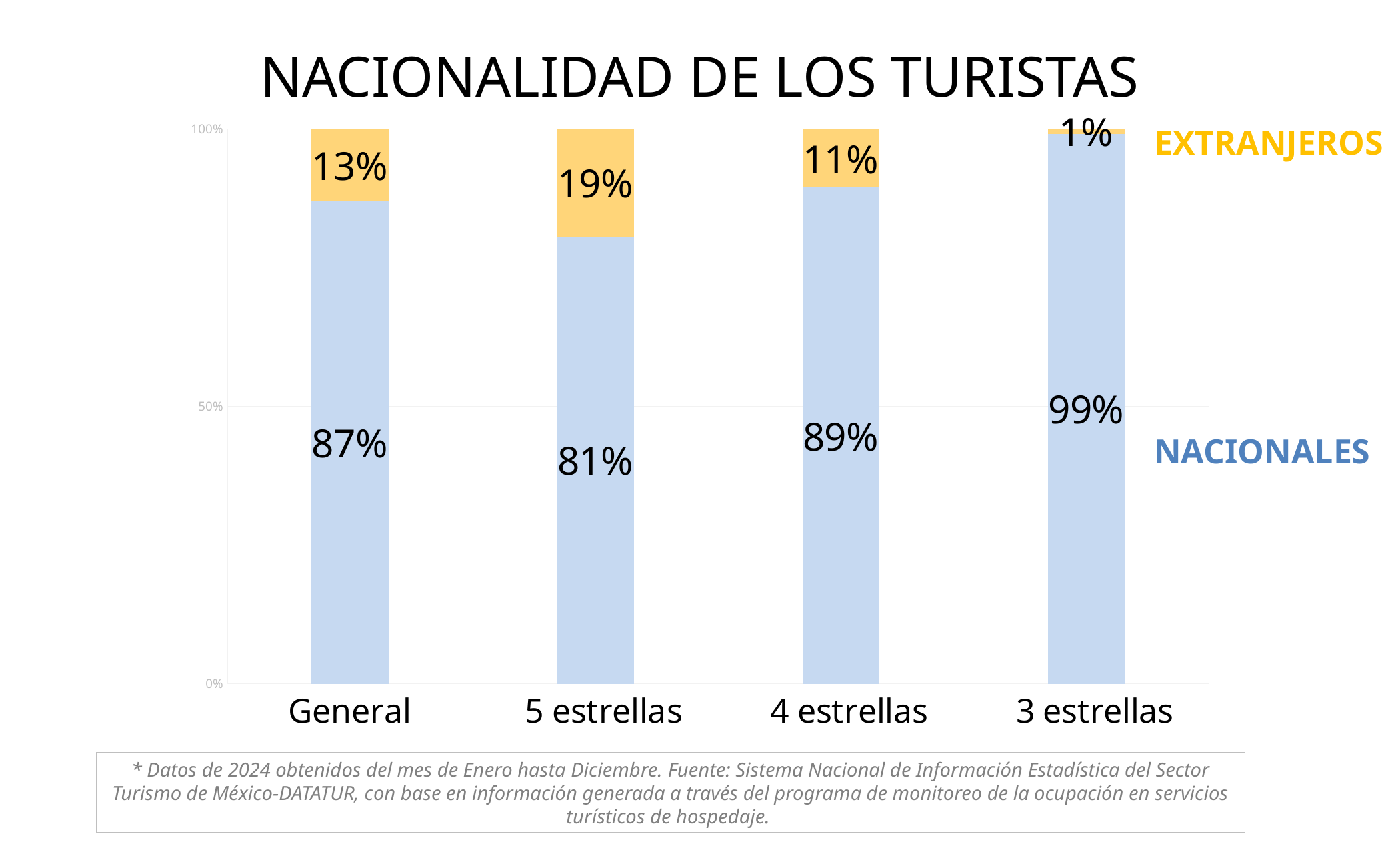
What kind of chart is this? Stacked bar chart What is the difference between the EXTRANJEROS values for 5 estrellas and 4 estrellas? 8% Which category has the highest EXTRANJEROS share? 5 estrellas What is the EXTRANJEROS value for General? 13% What is the EXTRANJEROS value for 3 estrellas? 1% What is the NACIONALES value for 4 estrellas? 89% How many categories are shown on the x axis? 4 Which is larger, the NACIONALES value for General or for 3 estrellas? 3 estrellas Which category has the lowest NACIONALES share? 5 estrellas How many series does the chart show? 2 What is the title of the chart? NACIONALIDAD DE LOS TURISTAS What is the NACIONALES value for 5 estrellas? 81%